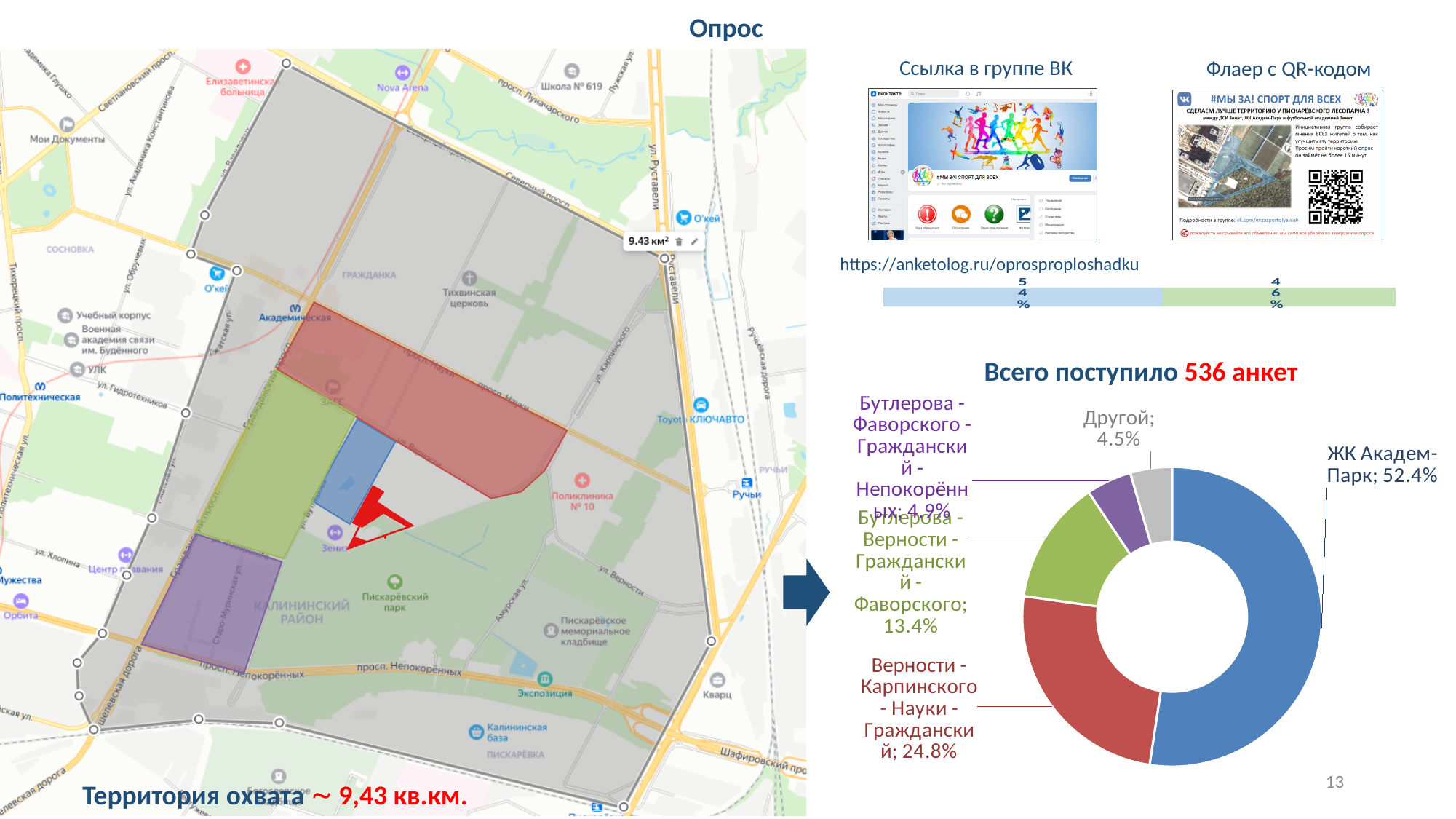
In the chart titled 'Всего поступило 536 анкет', which is larger: the share for Бутлерова - Верности - Гражданский - Фаворского or the share for Другой? Бутлерова - Верности - Гражданский - Фаворского In the chart titled 'Всего поступило 536 анкет', what share is labelled 'Другой'? 4.5% In the chart titled 'Всего поступило 536 анкет', what is the difference in share between ЖК Академ-Парк and Верности - Карпинского - Науки - Гражданский? 27.6% In the horizontal stacked bar below the anketolog.ru link, what percentage is shown on the blue segment? 54% In the chart titled 'Всего поступило 536 анкет', which category has the largest share? ЖК Академ-Парк In the chart titled 'Всего поступило 536 анкет', how many slices does the chart have? 5 In the chart titled 'Всего поступило 536 анкет', what share of responses came from the area Бутлерова - Фаворского - Гражданский - Непокорённых? 4.9% In the chart titled 'Всего поступило 536 анкет', what share of responses came from the area Верности - Карпинского - Науки - Гражданский? 24.8% What kind of chart is the one titled 'Всего поступило 536 анкет'? Doughnut (pie) chart In the chart titled 'Всего поступило 536 анкет', which category has the smallest share? Другой In the chart titled 'Всего поступило 536 анкет', what share of responses came from ЖК Академ-Парк? 52.4% In the chart titled 'Всего поступило 536 анкет', what share of responses came from the area Бутлерова - Верности - Гражданский - Фаворского? 13.4%